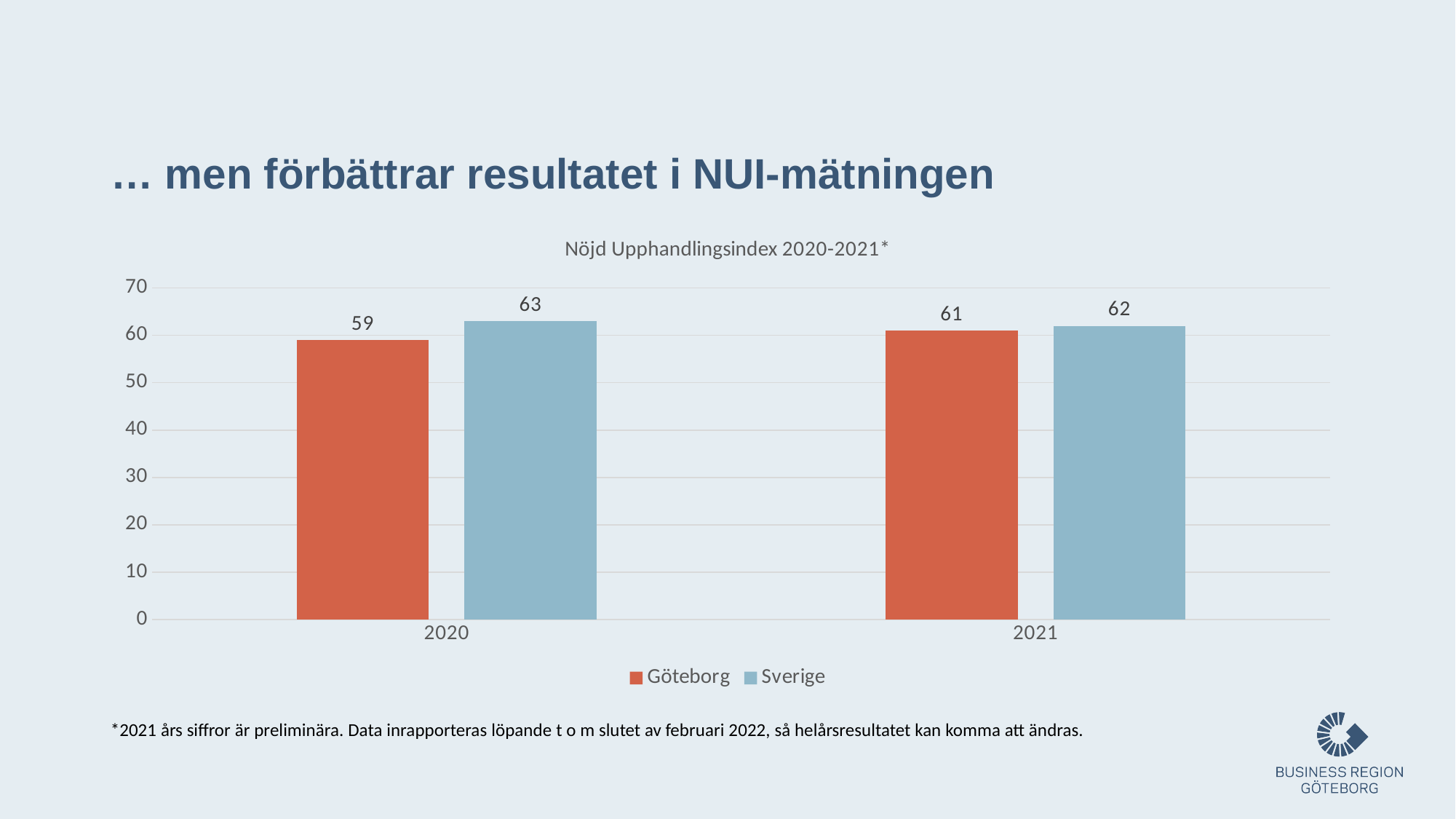
How many series does the legend list? 2 What is the value for Göteborg in 2021? 61 Which is larger: Göteborg in 2021 or Sverige in 2020? Sverige in 2020 What is the value for Göteborg in 2020? 59 How many years are shown on the x axis? 2 What is the value for Sverige in 2021? 62 By how much did Göteborg's value change from 2020 to 2021? 2 What kind of chart is shown on the slide? Bar chart Is the value for Göteborg in 2020 greater or less than 60? less What is the difference between Sverige and Göteborg in 2020? 4 Which series has the highest value in 2020? Sverige Which bar has the lowest value in the chart? Göteborg in 2020